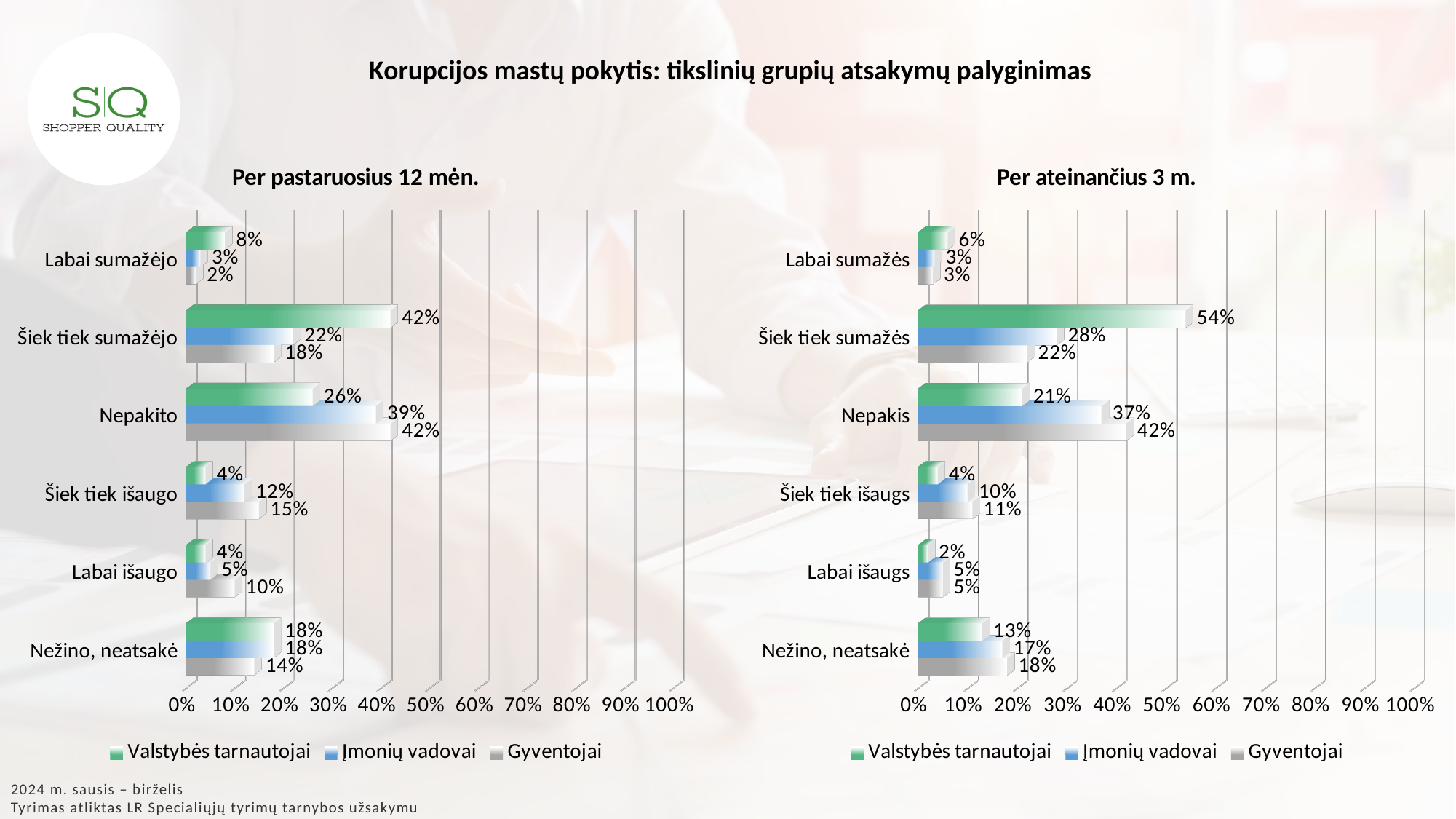
How many series does the legend of the chart titled "Per ateinančius 3 m." list? 3 In the chart titled "Per ateinančius 3 m.", what is the value for Gyventojai in the "Nepakis" category? 42% In the chart titled "Per pastaruosius 12 mėn.", which series is shown in green according to the legend? Valstybės tarnautojai In the chart titled "Per ateinančius 3 m.", what is the value for Įmonių vadovai in the "Šiek tiek sumažės" category? 28% In the chart titled "Per ateinančius 3 m.", which is larger in the "Nežino, neatsakė" category: the value for Įmonių vadovai or for Gyventojai? Gyventojai In the chart titled "Per ateinančius 3 m.", is the value for Valstybės tarnautojai in "Šiek tiek sumažės" greater or less than 50%? greater In the chart titled "Per pastaruosius 12 mėn.", which category has the highest value for Įmonių vadovai? Nepakito How many categories are shown on the y axis of the chart titled "Per pastaruosius 12 mėn."? 6 In the chart titled "Per pastaruosius 12 mėn.", what is the value for Valstybės tarnautojai in the "Šiek tiek sumažėjo" category? 42% What type of chart is the chart titled "Per pastaruosius 12 mėn."? Bar chart In the chart titled "Per pastaruosius 12 mėn.", what is the difference between the Gyventojai and Valstybės tarnautojai values in the "Nepakito" category? 16% In the chart titled "Per ateinančius 3 m.", which category has the lowest value for Valstybės tarnautojai? Labai išaugs